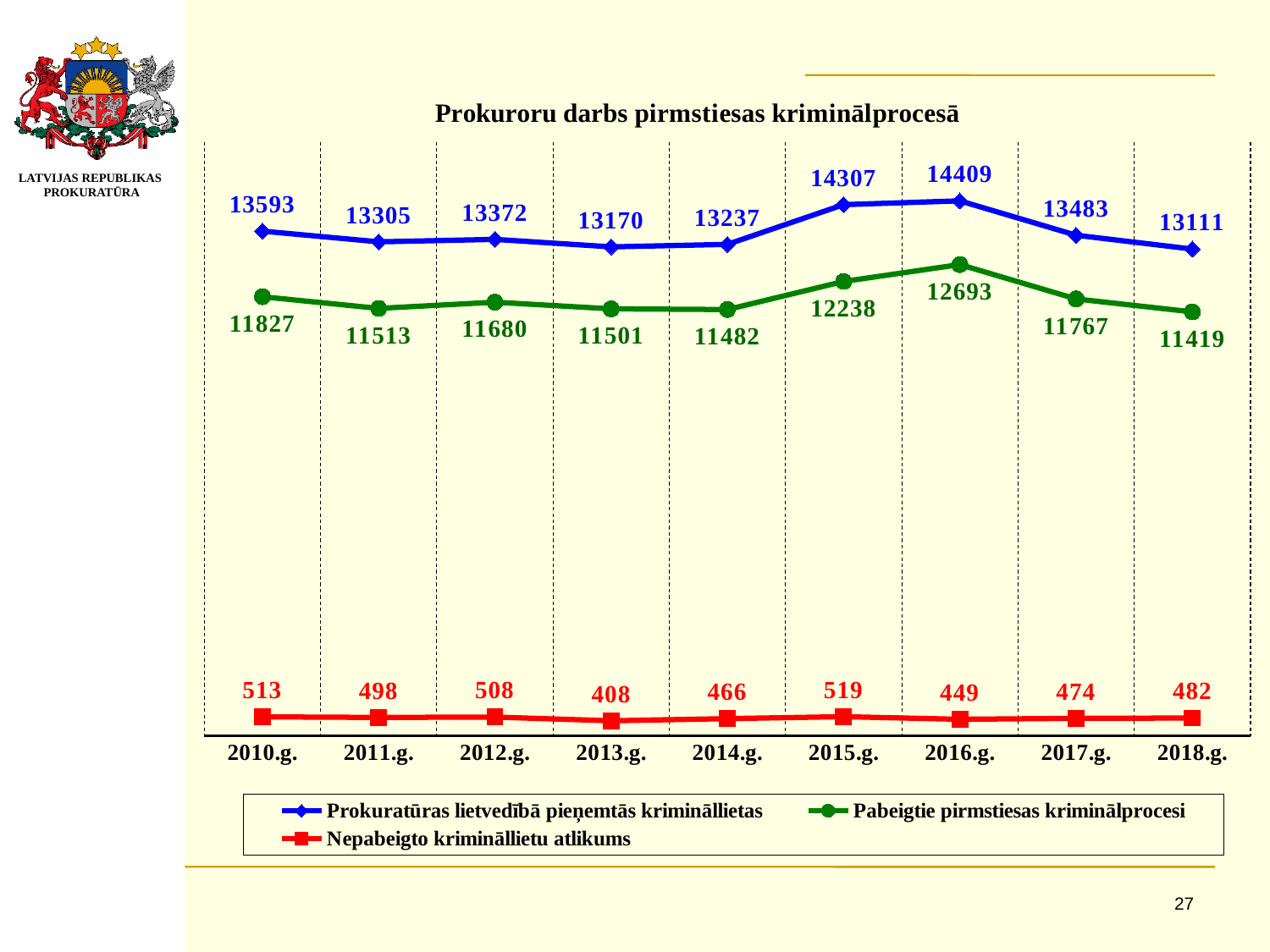
What is the title of the chart? Prokuroru darbs pirmstiesas kriminālprocesā Which is larger: Nepabeigto krimināllietu atlikums in 2010.g. or in 2012.g.? 2010.g. What is the value of Nepabeigto krimināllietu atlikums in 2015.g.? 519 How many series does the legend list? 3 What is the value of Pabeigtie pirmstiesas kriminālprocesi in 2013.g.? 11501 In which year is Nepabeigto krimināllietu atlikums lowest? 2013.g. In which year is Pabeigtie pirmstiesas kriminālprocesi highest? 2016.g. Does Prokuratūras lietvedībā pieņemtās krimināllietas rise or fall from 2016.g. to 2018.g.? fall How many years are shown on the x axis? 9 What is the value of Prokuratūras lietvedībā pieņemtās krimināllietas in 2016.g.? 14409 What kind of chart is shown? line chart What is the difference between Prokuratūras lietvedībā pieņemtās krimināllietas and Pabeigtie pirmstiesas kriminālprocesi in 2018.g.? 1692